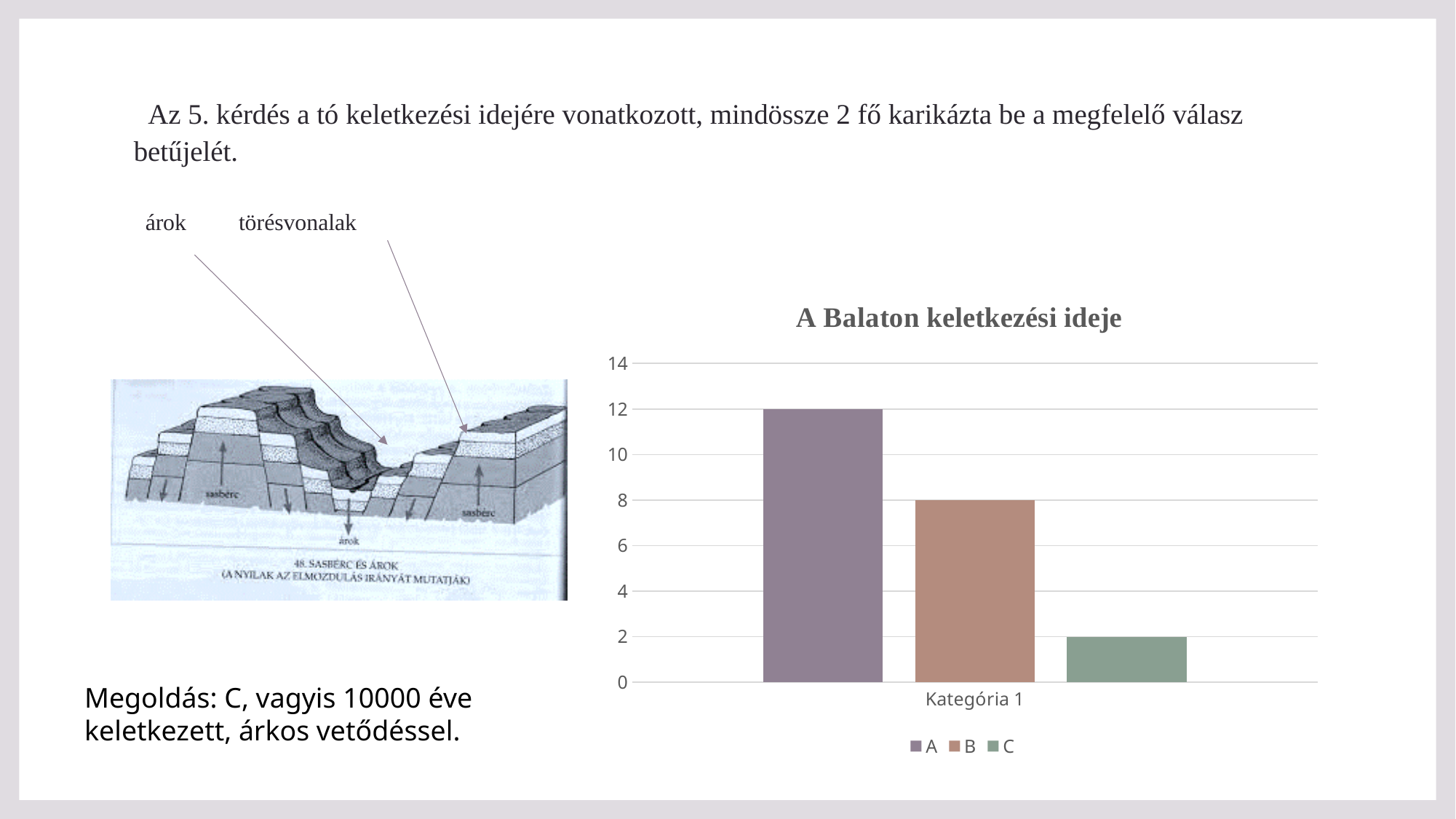
How many categories are shown on the x axis of the chart? 1 Which is larger, the value of series B or the value of series C? B Which series has the highest value in the chart? A What is the value of series B for Kategória 1? 8 What kind of chart is shown on the slide? bar chart Which series has the lowest value in the chart? C What is the value of series A for Kategória 1? 12 Is the value for series A greater or less than 10? greater What is the title of the chart? A Balaton keletkezési ideje What is the value of series C for Kategória 1? 2 What is the difference between the values of series A and series B? 4 How many series does the chart legend list? 3